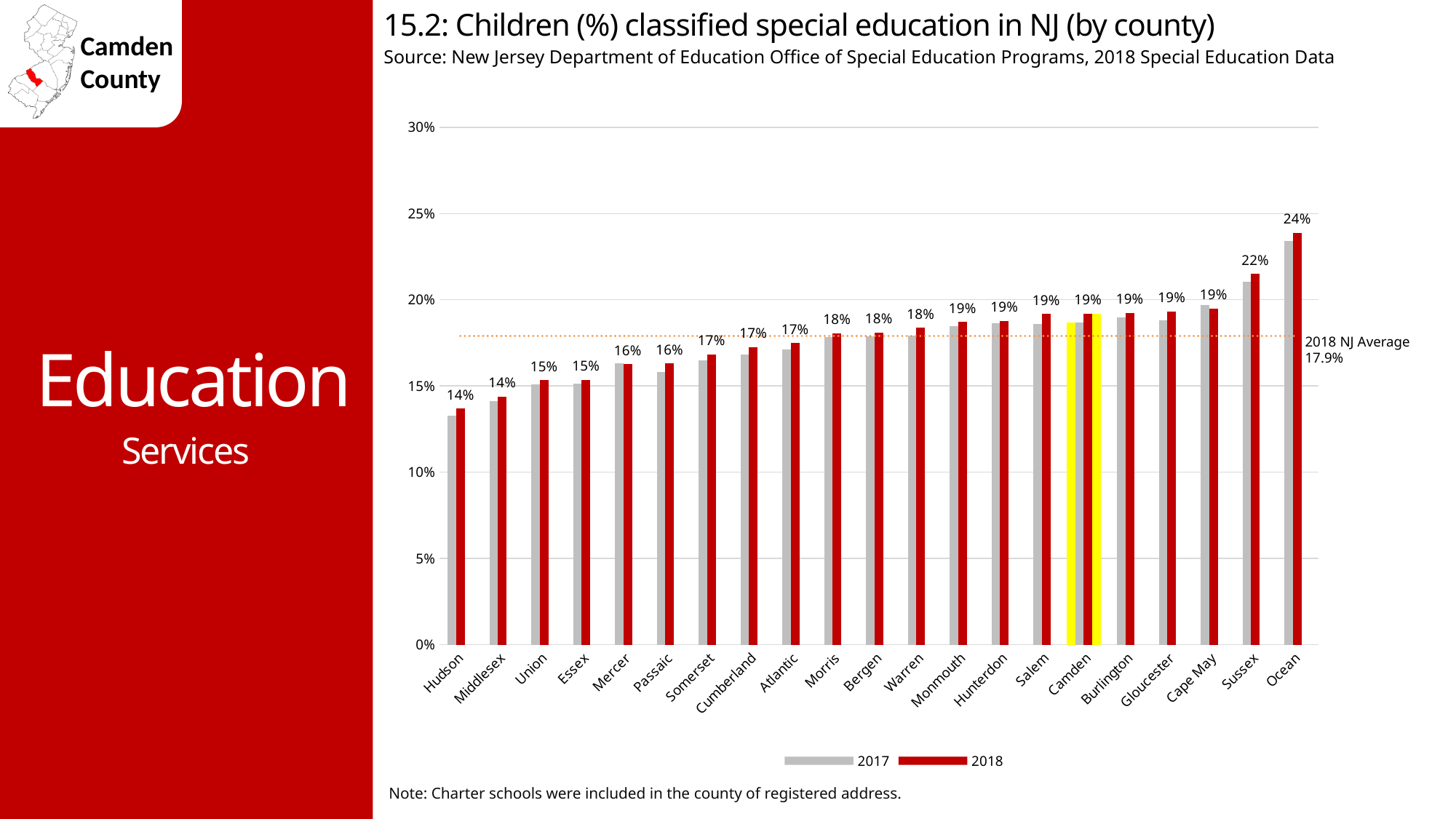
Which county has the highest 2018 value in the chart? Ocean How many series does the chart legend list? 2 What is the 2018 value labelled for Ocean? 24% Which has the larger 2018 value, Sussex or Morris? Sussex What kind of chart is shown on the slide? Bar chart What is the 2018 value labelled for Mercer? 16% What is the 2018 NJ Average value marked by the dotted line on the chart? 17.9% Is the 2017 value for Hudson greater or less than 15%? less What is the 2018 value labelled for Sussex? 22% What is the 2018 value labelled for Camden? 19% How many counties are shown on the x axis of the chart? 21 What is the difference between the 2018 labelled values for Ocean and Hudson? 10 percentage points